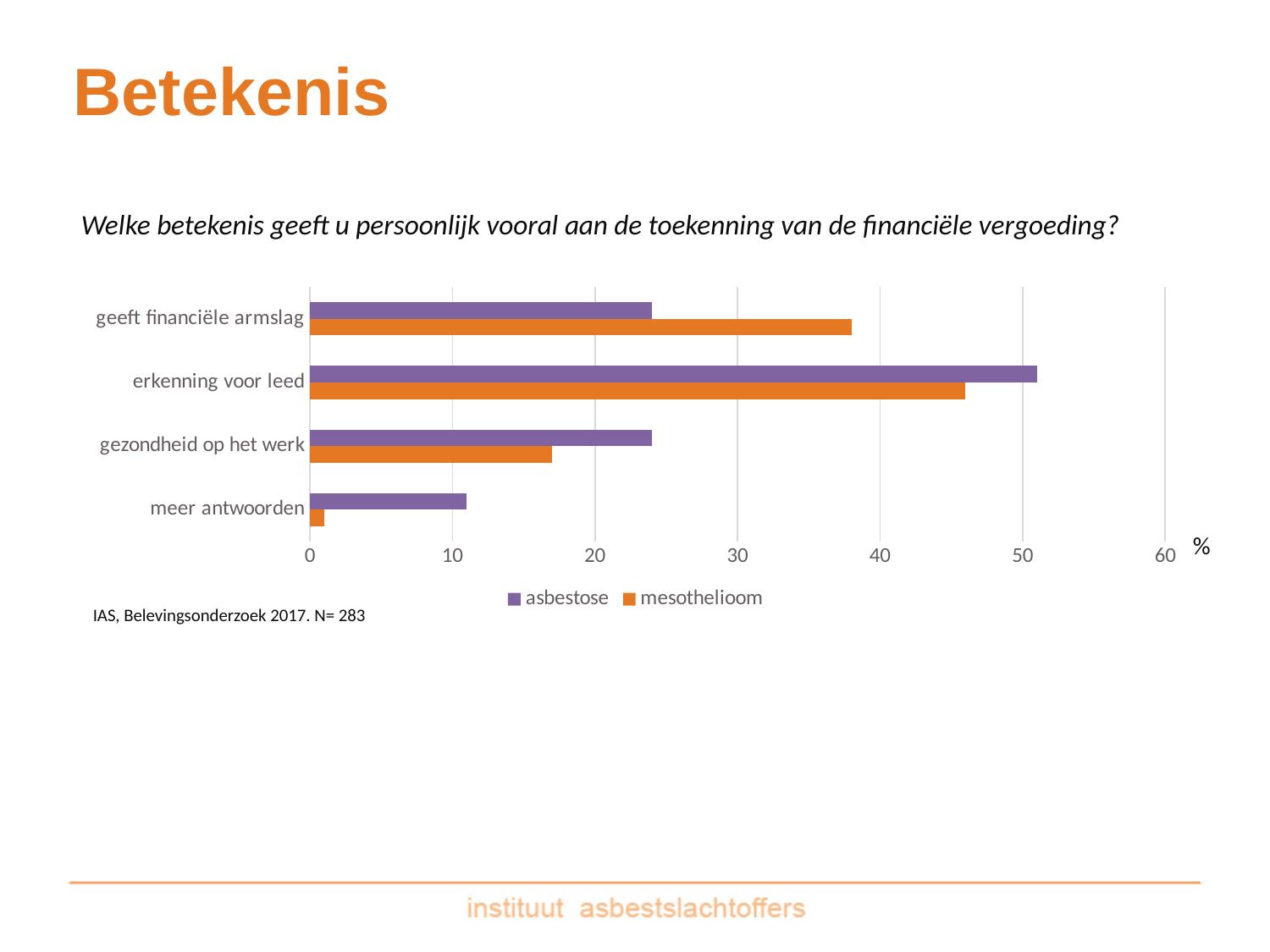
For 'geeft financiële armslag', which series has the larger value, asbestose or mesothelioom? mesothelioom What colour are the bars for the mesothelioom series? orange Which category has the highest value for asbestose? erkenning voor leed Which category has the lowest value for mesothelioom? meer antwoorden Is the mesothelioom value for 'meer antwoorden' greater or less than 10? less For 'gezondheid op het werk', which series has the larger value, asbestose or mesothelioom? asbestose Which category has the highest value for mesothelioom? erkenning voor leed What kind of chart is shown on the slide? bar chart How many series does the legend list? 2 How many categories are shown on the chart? 4 Is the asbestose value for 'erkenning voor leed' greater or less than 40? greater Is the mesothelioom value for 'geeft financiële armslag' greater or less than 30? greater